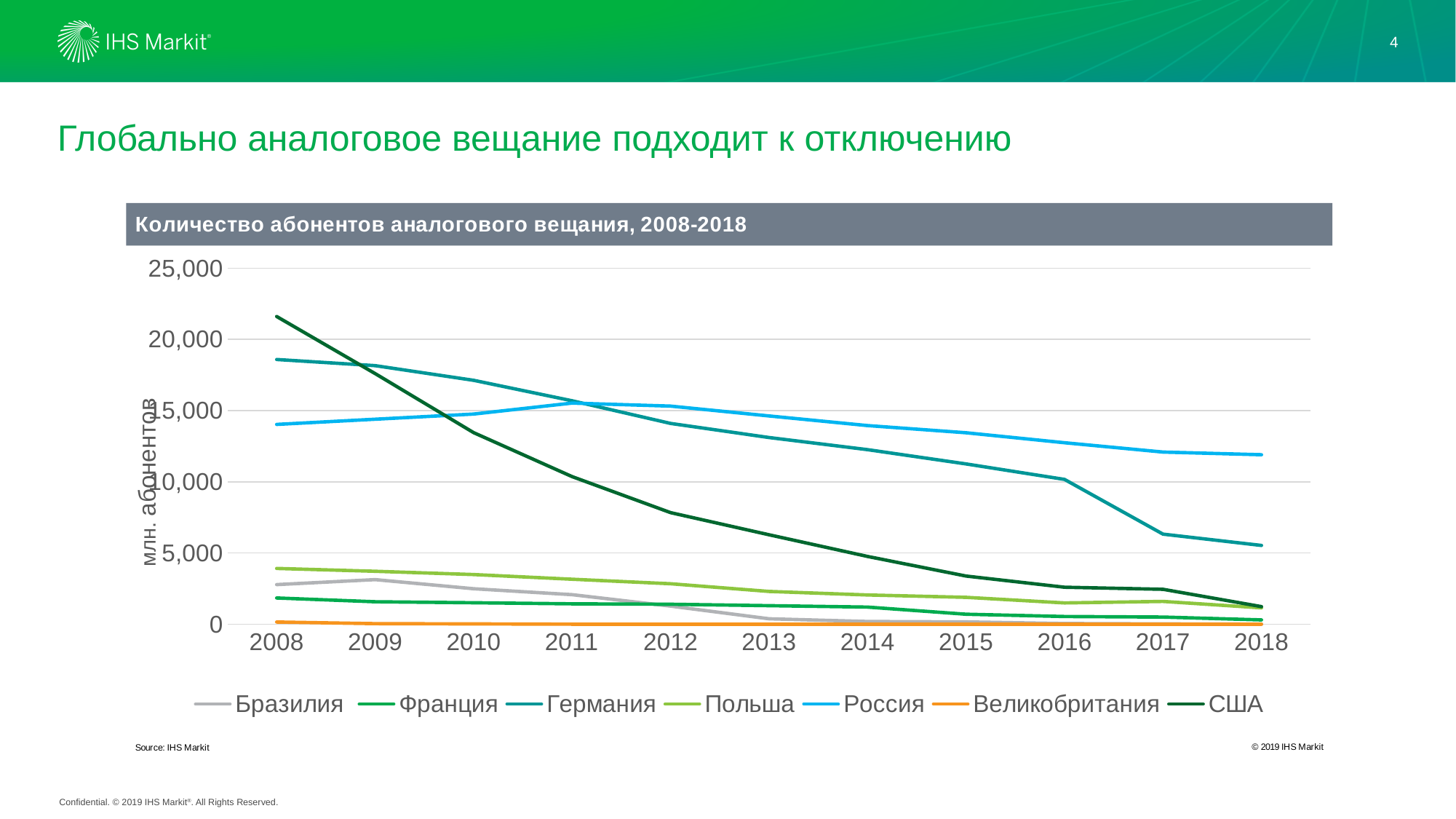
How many series does the legend list? 7 What kind of chart is shown on the slide? line chart How many years are shown along the x axis? 11 Which country has the lowest value in 2008? Великобритания Does the line for США rise or fall from 2008 to 2018? fall Is the value for Россия in 2018 greater or less than 15,000? less Which country has the highest value in 2008? США In 2008, which is larger: the value for Германия or the value for Россия? Германия What is the label on the y axis? млн. абонентов What is the title of the chart? Количество абонентов аналогового вещания, 2008-2018 Which country has the highest value in 2018? Россия Is the value for США in 2008 greater or less than 20,000? greater